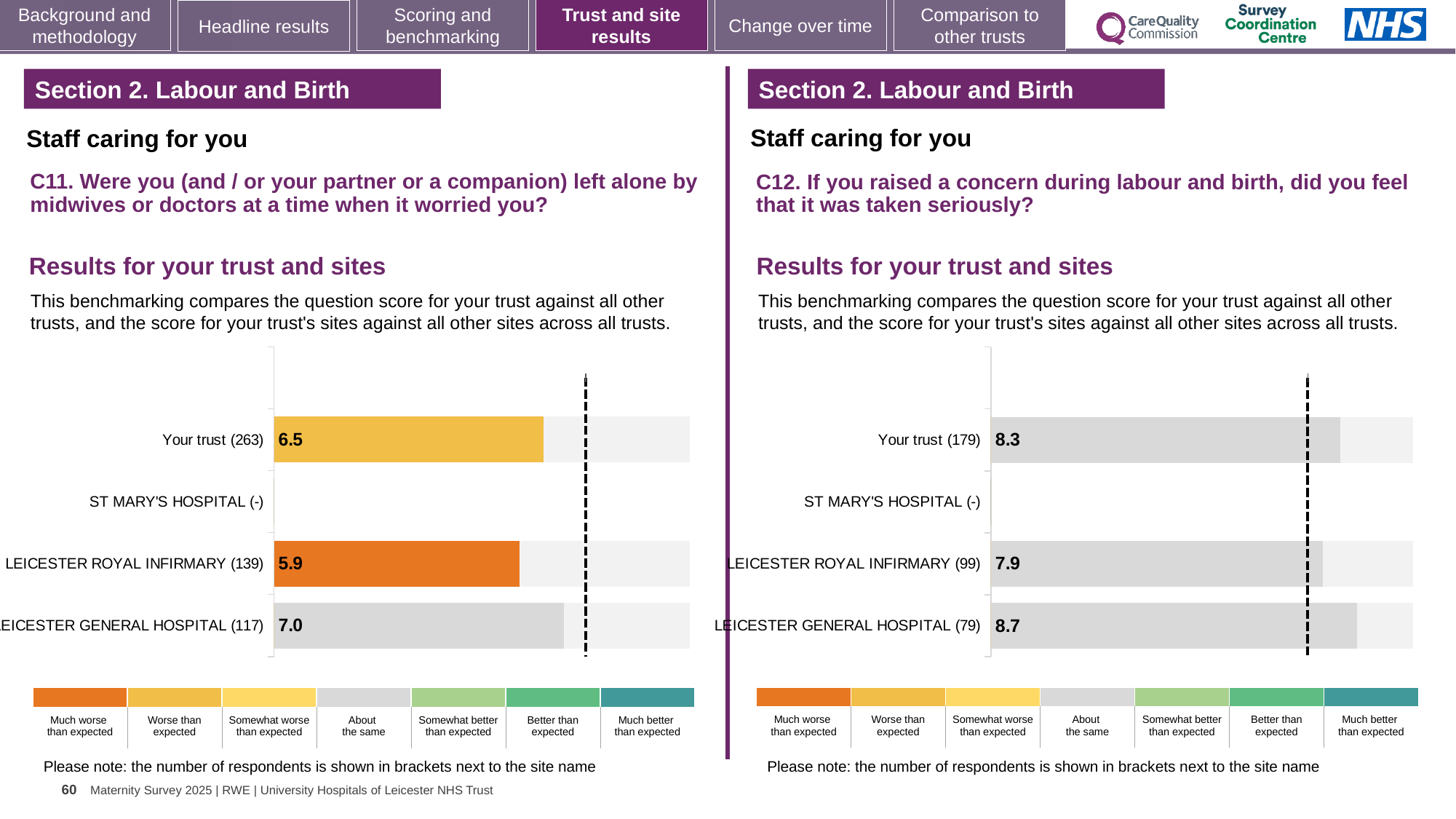
In the C12 chart on the right, is the score for Your trust (179) or Leicester Royal Infirmary (99) larger? Your trust (179) In the C12 chart on the right, what is the difference between the scores for Leicester General Hospital (79) and Your trust (179)? 0.4 In the C11 chart on the left, what colour is the bar for Leicester Royal Infirmary (139)? Orange In the C11 chart on the left, what is the score for Your trust (263)? 6.5 In the C11 chart on the left, which site or trust has the highest score? Leicester General Hospital (117) In the C11 chart on the left, what is the score for Leicester Royal Infirmary (139)? 5.9 What kind of chart is used in the C11 chart on the left? Bar chart In the C12 chart on the right, what is the score for Your trust (179)? 8.3 In the C12 chart on the right, what is the score for Leicester General Hospital (79)? 8.7 In the C11 chart on the left, what is the difference between the scores for Leicester General Hospital (117) and Leicester Royal Infirmary (139)? 1.1 In the C12 chart on the right, which site or trust has the lowest score? Leicester Royal Infirmary (99) In the C11 chart on the left, which site or trust has the lowest score? Leicester Royal Infirmary (139)